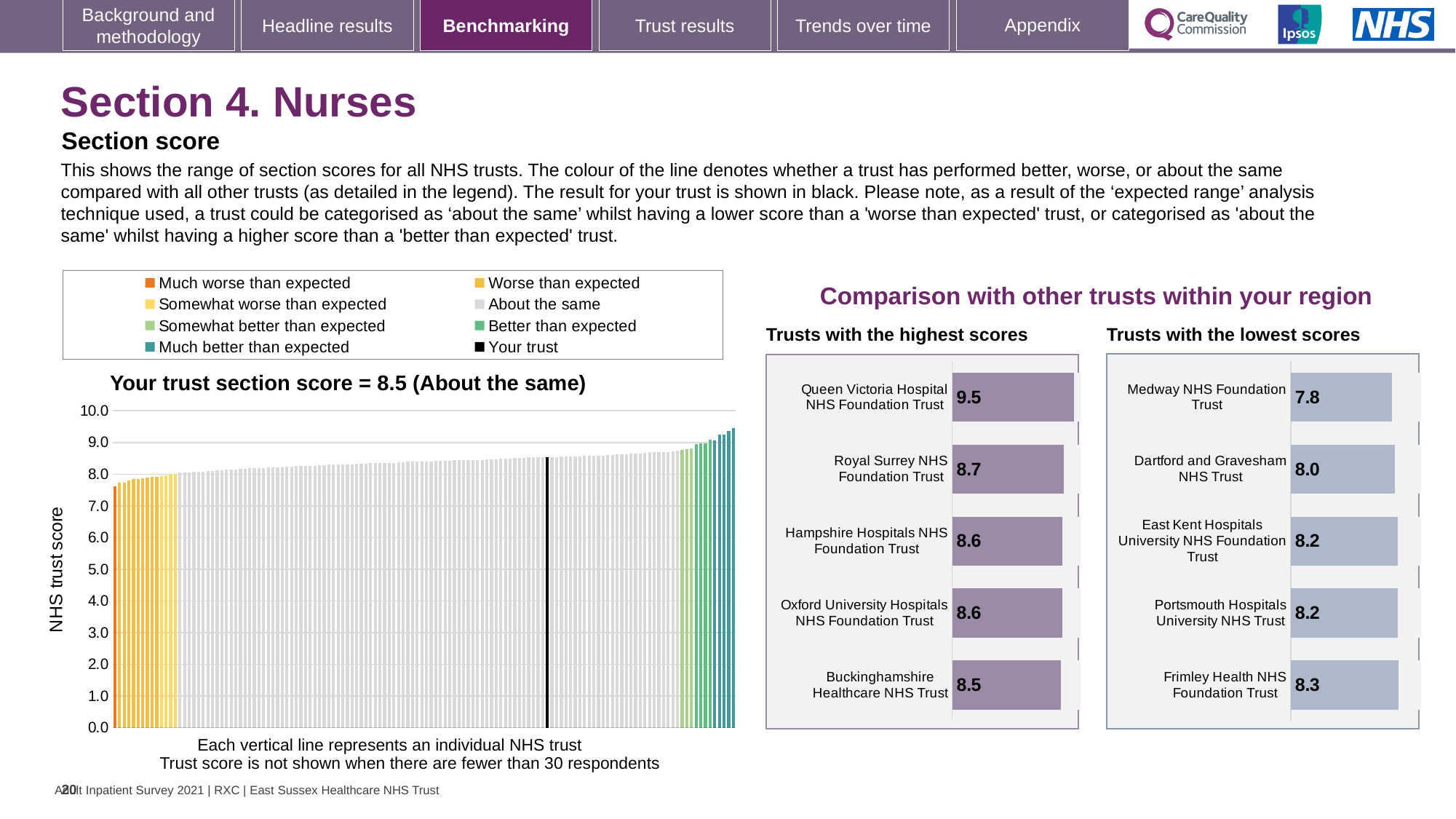
What kind of chart is the 'Your trust section score' chart? bar chart In the 'Trusts with the lowest scores' chart, what is the score for Medway NHS Foundation Trust? 7.8 In the 'Trusts with the lowest scores' chart, which has the larger score: Frimley Health NHS Foundation Trust or Dartford and Gravesham NHS Trust? Frimley Health NHS Foundation Trust In the 'Trusts with the lowest scores' chart, which trust has the lowest score? Medway NHS Foundation Trust In the 'Your trust section score' chart, what is the highest value shown on the y axis? 10.0 In the 'Trusts with the highest scores' chart, which trust has the highest score? Queen Victoria Hospital NHS Foundation Trust In the 'Trusts with the highest scores' chart, what is the score for Queen Victoria Hospital NHS Foundation Trust? 9.5 In the 'Trusts with the highest scores' chart, what is the difference between the scores of Queen Victoria Hospital NHS Foundation Trust and Buckinghamshire Healthcare NHS Trust? 1.0 In the 'Trusts with the highest scores' chart, how many trusts are shown? 5 In the 'Your trust section score' chart, do the trust scores rise or fall from left to right along the x axis? rise How many entries does the legend above the 'Your trust section score' chart list? 8 In the 'Your trust section score' chart, what is the section score for your trust? 8.5